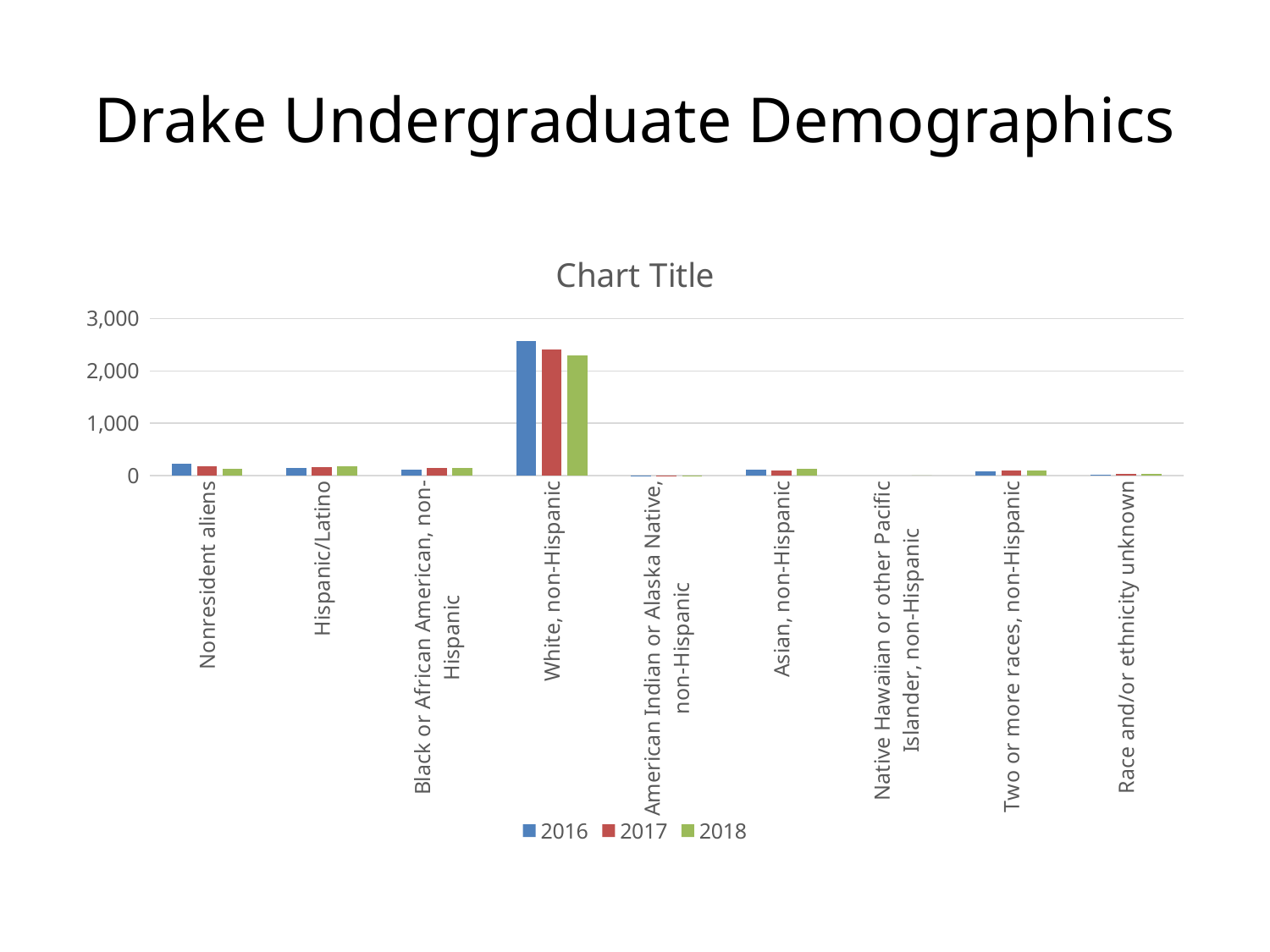
For White, non-Hispanic, which is larger: the 2016 value or the 2018 value? 2016 Which colour represents the 2018 series in the chart? Green Is the 2016 value for White, non-Hispanic greater or less than 2,000? greater Do the values for White, non-Hispanic rise or fall from 2016 to 2018? fall Is the 2017 value for Nonresident aliens greater or less than 1,000? less How many categories are shown on the x axis of the chart? 9 What kind of chart is shown on the slide? Bar chart How many series does the chart's legend list? 3 Is the 2018 value for Hispanic/Latino greater or less than 1,000? less What is the title shown above the chart? Chart Title Which category has the lowest values in the chart? Native Hawaiian or other Pacific Islander, non-Hispanic Which category has the highest values in the chart? White, non-Hispanic